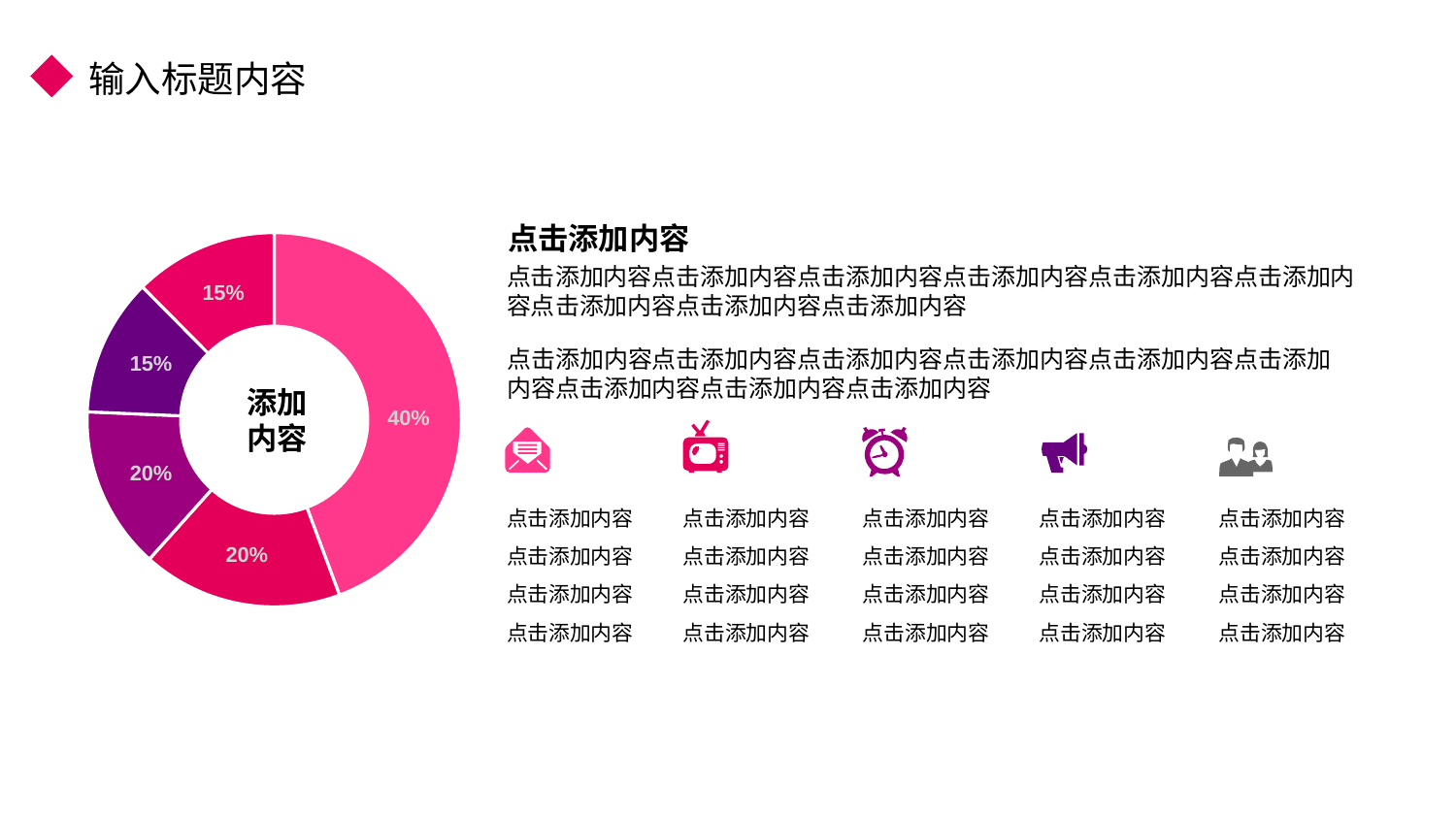
What is the value of the largest slice in the doughnut chart? 40% Which is larger in the doughnut chart: the pink slice on the right or the dark purple slice on the left? the pink slice on the right What is the difference between the largest slice (40%) and the bottom slice (20%) in the doughnut chart? 20 percentage points What value is shown on the large pink slice on the right side of the doughnut chart? 40% How many slices in the doughnut chart are labelled 20%? 2 How many slices in the doughnut chart are labelled 15%? 2 What value is shown on the slice at the bottom of the doughnut chart? 20% What text appears in the centre of the doughnut chart? 添加内容 How many slices does the doughnut chart have? 5 What kind of chart is shown on the left of the slide? doughnut chart What value is shown on the dark purple slice on the left side of the doughnut chart? 15% What is the value of the smallest slices in the doughnut chart? 15%